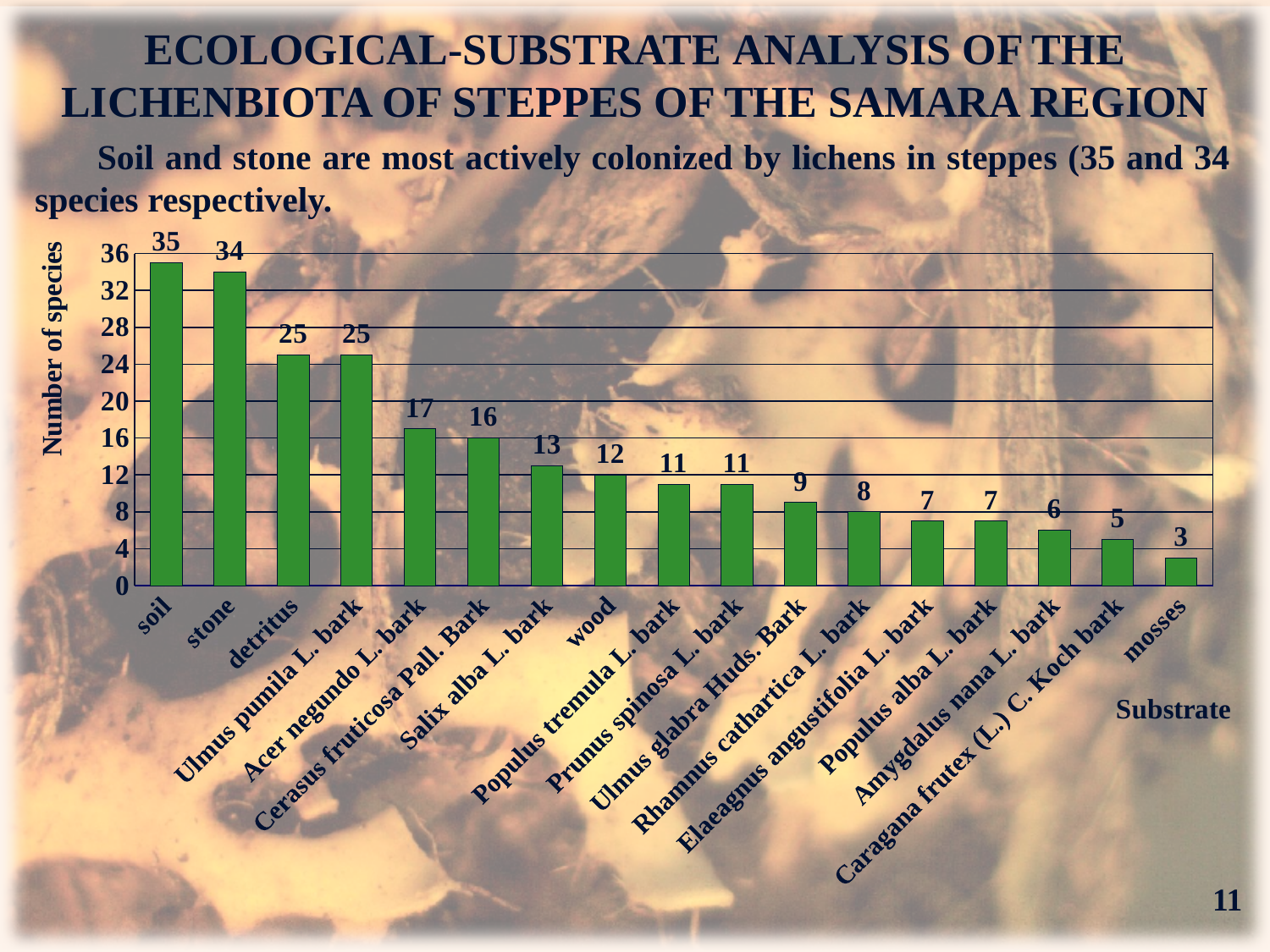
How many substrate categories are shown in the chart? 17 What type of chart is shown on the slide? bar chart Which has more species, Cerasus fruticosa Pall. Bark or Ulmus glabra Huds. Bark? Cerasus fruticosa Pall. Bark Which substrate has the lowest number of species? mosses What is the difference in number of species between detritus and Acer negundo L. bark? 8 What is the difference in number of species between soil and stone? 1 What is the number of species for Salix alba L. bark? 13 What is the number of species for wood? 12 What is the number of species for soil? 35 What is the number of species for mosses? 3 Which substrate has the highest number of species? soil What is the label of the vertical axis of the chart? Number of species